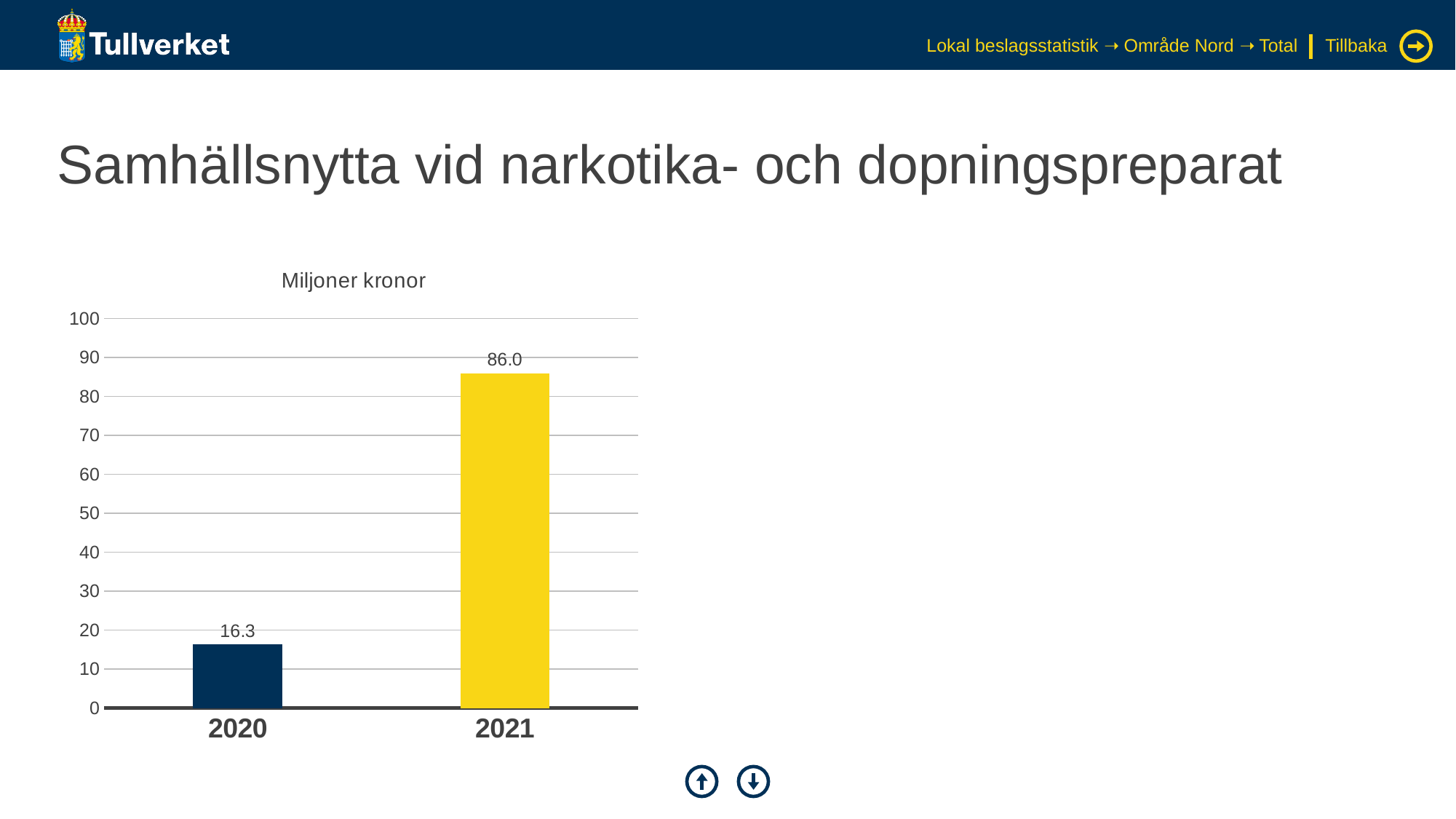
Is the value for 2021 greater or less than 80? greater What unit label is shown above the chart? Miljoner kronor What kind of chart is shown on the slide? bar chart What is the value for 2020? 16.3 Is the value for 2020 greater or less than 20? less What is the value for 2021? 86.0 Which year has the highest value? 2021 Do the values rise or fall from 2020 to 2021? rise Which year has the lowest value? 2020 How many years are shown on the x axis? 2 Which is larger, the value for 2020 or the value for 2021? 2021 What is the difference between the values for 2021 and 2020? 69.7